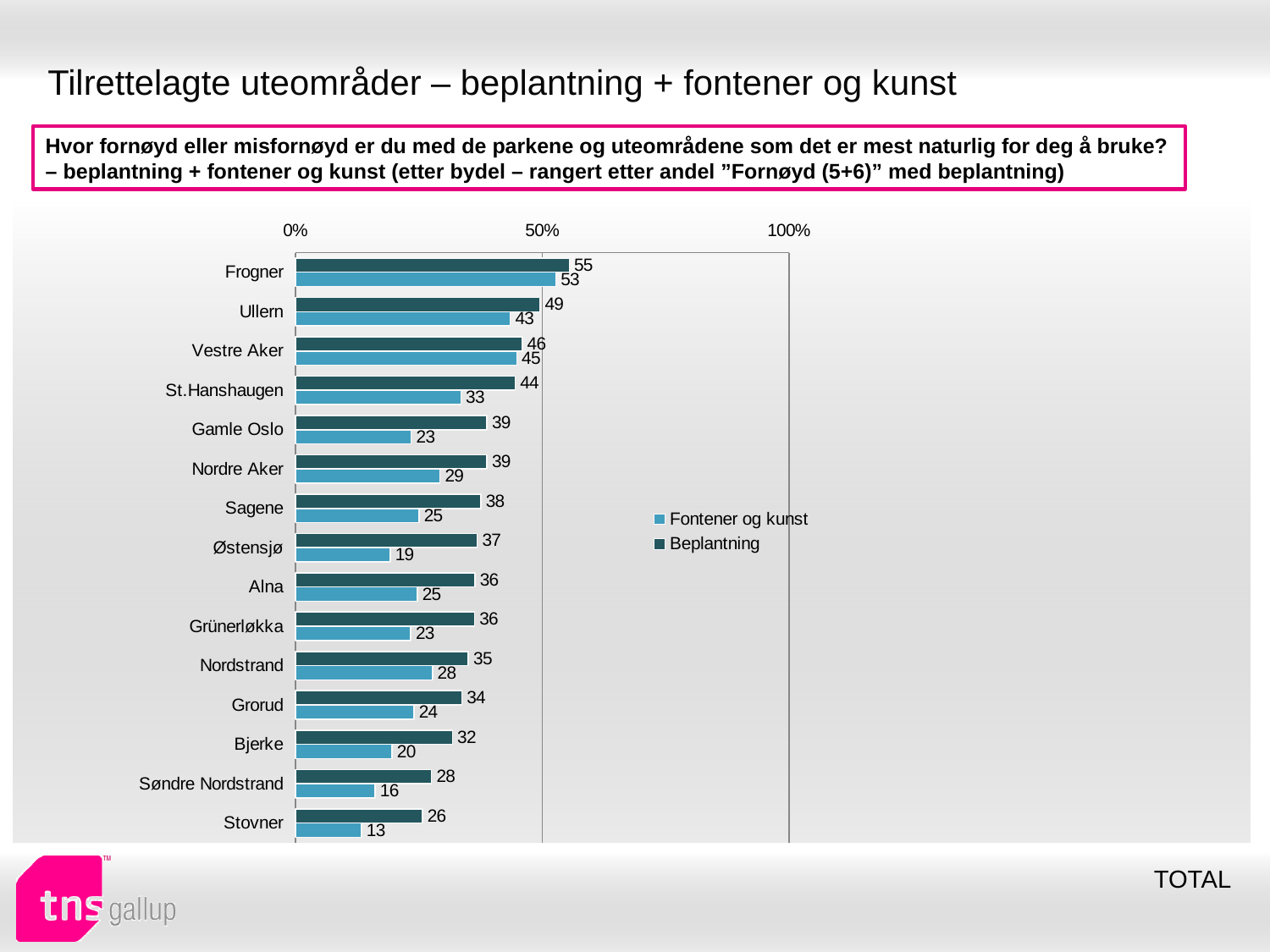
What is the difference between the Beplantning and Fontener og kunst values for Gamle Oslo? 16 Which is larger for Ullern: the Beplantning value or the Fontener og kunst value? Beplantning Is the Beplantning value for Frogner greater or less than 50%? greater Which district has the highest Beplantning value? Frogner How many districts are shown in the chart? 15 What are the two series named in the legend? Fontener og kunst and Beplantning Which district has the lowest Fontener og kunst value? Stovner What is the Fontener og kunst value for Stovner? 13 How many series does the legend list? 2 What is the Beplantning value for Frogner? 55 What is the Fontener og kunst value for Østensjø? 19 What kind of chart is shown on the slide? Bar chart